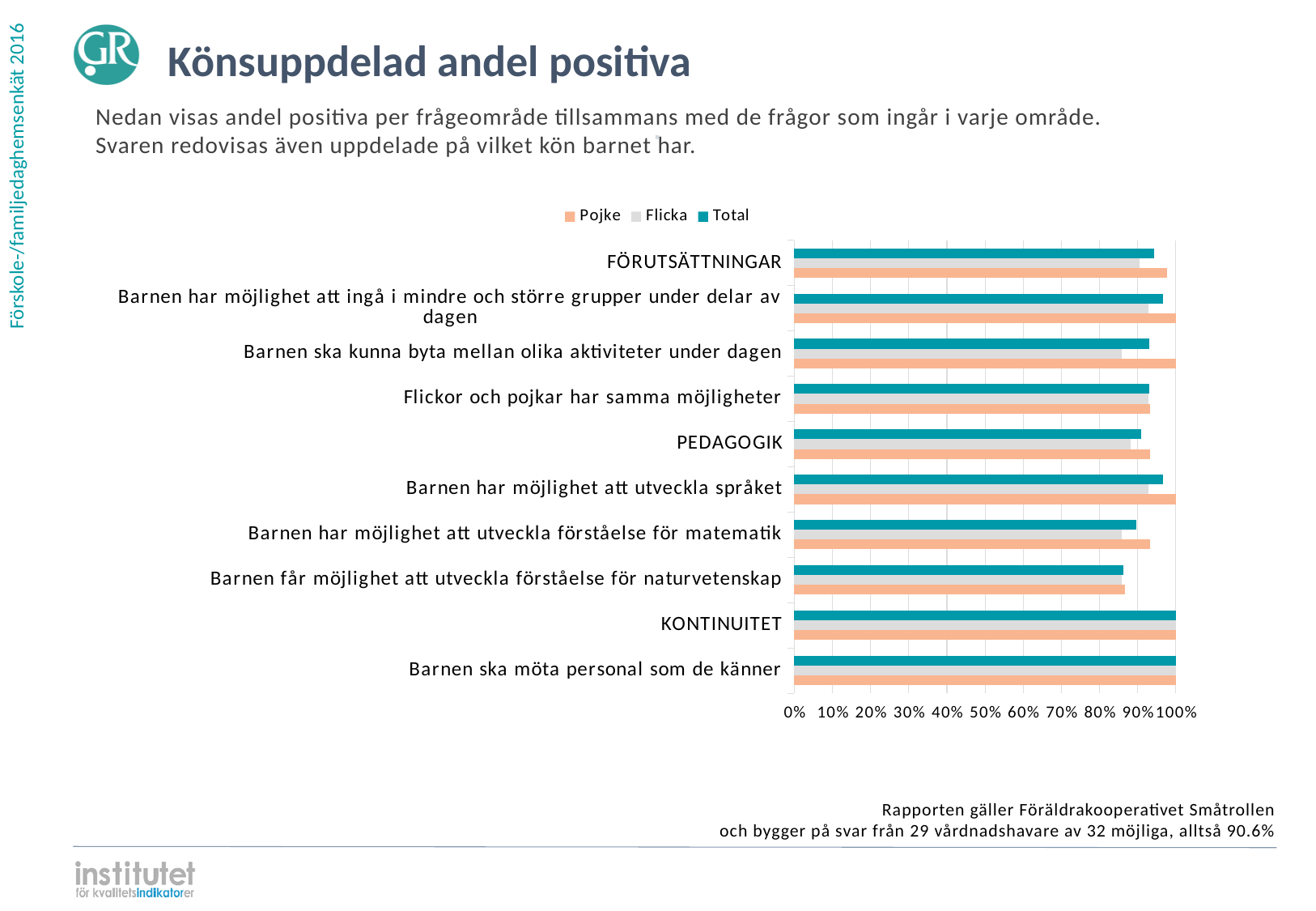
How many categories are plotted on the chart? 10 What is the Total value for KONTINUITET? 100% Is the Pojke value for 'Barnen får möjlighet att utveckla förståelse för naturvetenskap' greater or less than 90%? less What is the title of the slide containing the chart? Könsuppdelad andel positiva What kind of chart is shown on the slide? bar chart Is the Flicka value for 'Barnen har möjlighet att utveckla förståelse för matematik' greater or less than 90%? less What are the series names listed in the legend? Pojke, Flicka, Total Is the Total value for FÖRUTSÄTTNINGAR greater or less than 80%? greater How many series does the legend list? 3 For 'Barnen ska kunna byta mellan olika aktiviteter under dagen', which is larger: the Pojke value or the Flicka value? Pojke Which category has the lowest Pojke value? Barnen får möjlighet att utveckla förståelse för naturvetenskap